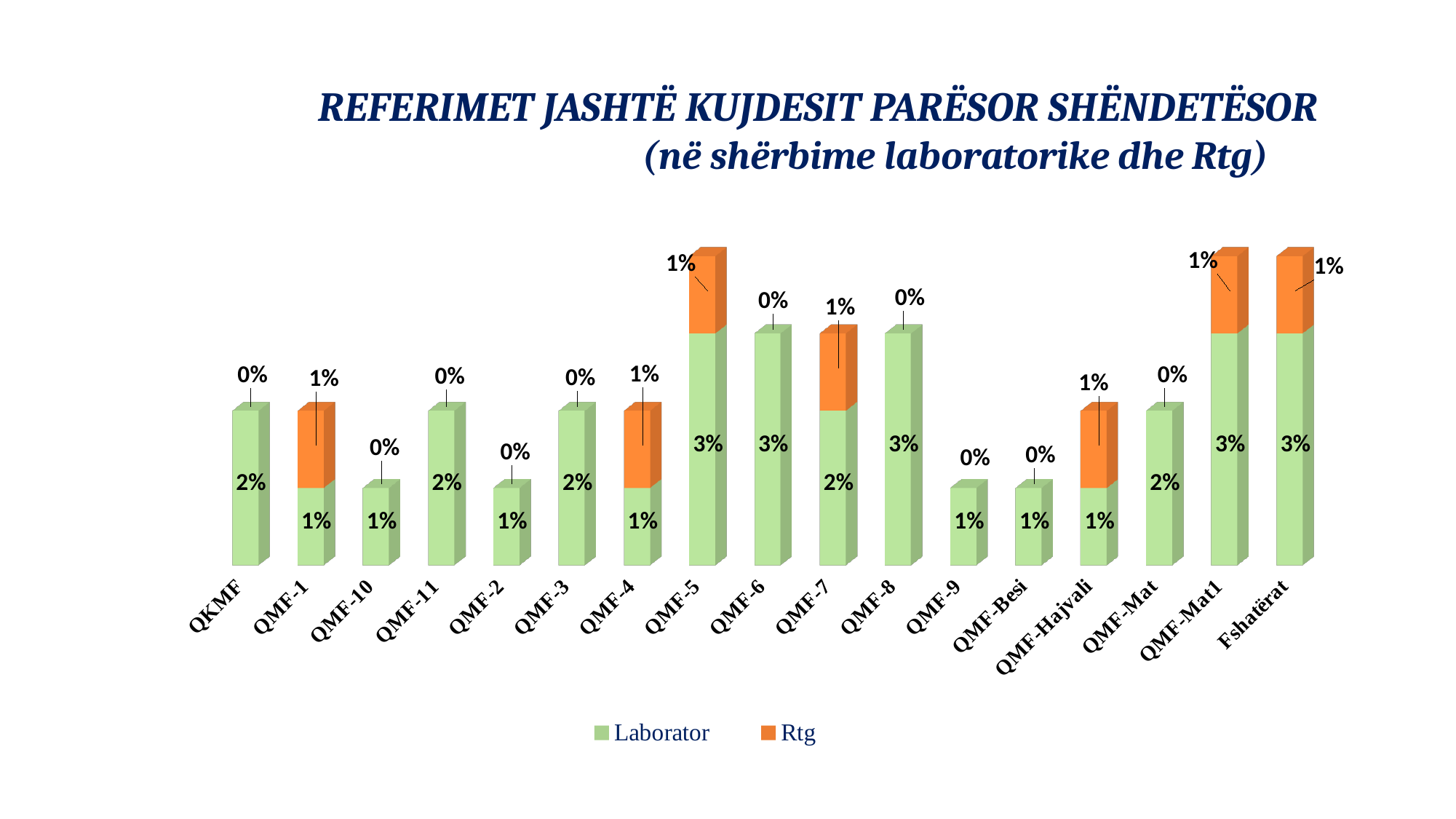
What kind of chart is shown on the slide? Stacked bar chart Which colour represents the Rtg series in the legend? Orange What is the total of the stacked bar for QMF-Mat1? 4% What is the Laborator value for QMF-Mat? 2% What is the difference between the Laborator values for QMF-6 and QMF-9? 2% How many series does the legend list? 2 What is the total of the stacked bar for QMF-7? 3% Which has the larger Laborator value, QKMF or QMF-2? QKMF How many categories are shown on the x axis? 17 What is the Rtg value for QMF-Hajvali? 1% What is the Laborator value for QMF-5? 3% What is the Rtg value for QMF-8? 0%